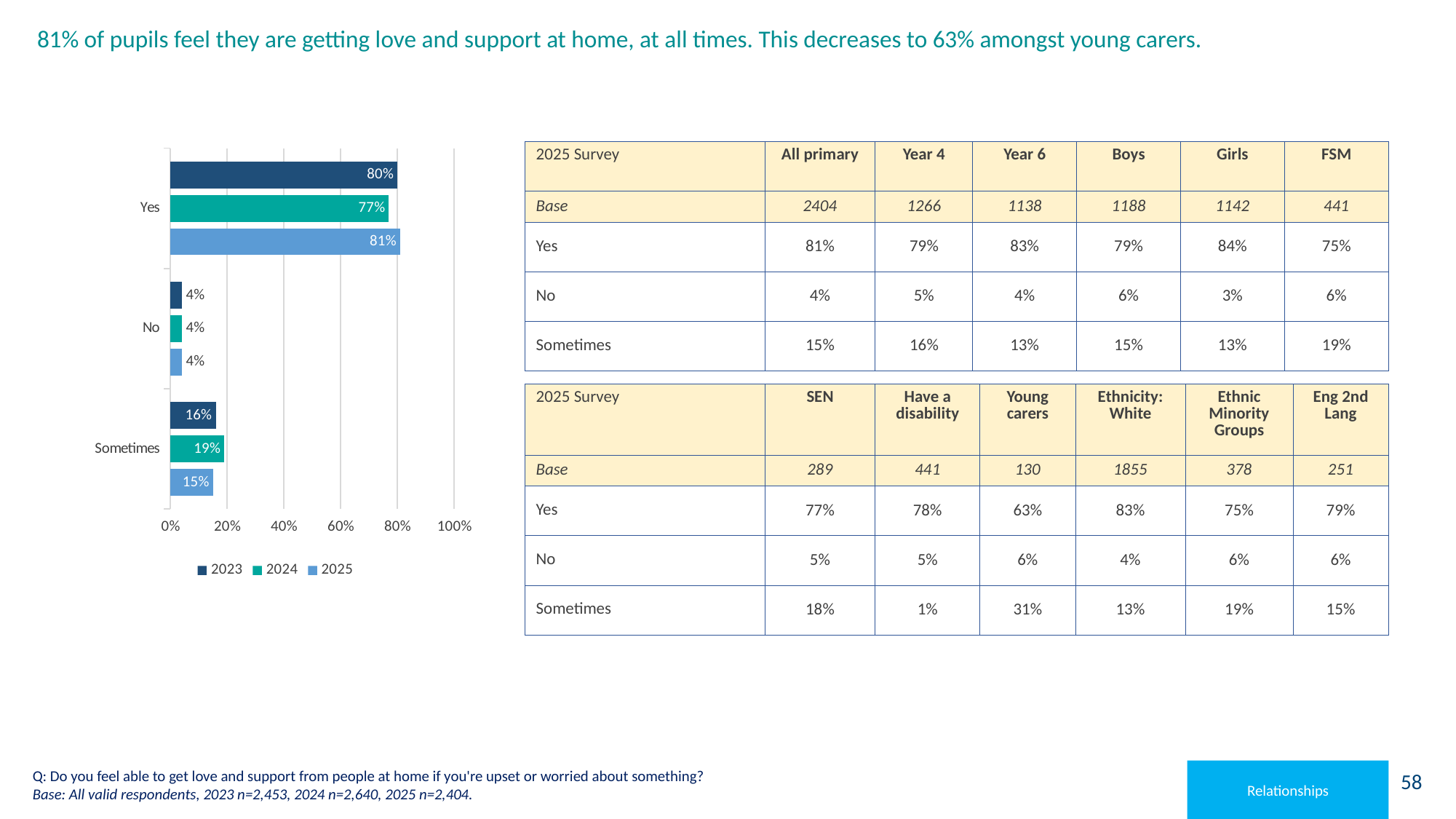
How many series does the legend list? 3 What is the difference between the Yes values for 2025 and 2024? 4 percentage points What is the value for Sometimes in 2024? 19% How many categories are shown on the chart? 3 Which category has the lowest value in the 2025 series? No What is the value for No in 2023? 4% Which is larger, the Sometimes value for 2024 or for 2025? 2024 Which years are listed in the chart legend? 2023, 2024, 2025 What is the value for Yes in 2025? 81% Is the value for Yes in 2024 greater or less than 60%? greater What kind of chart is shown on the slide? Bar chart Which category has the highest value in the 2023 series? Yes